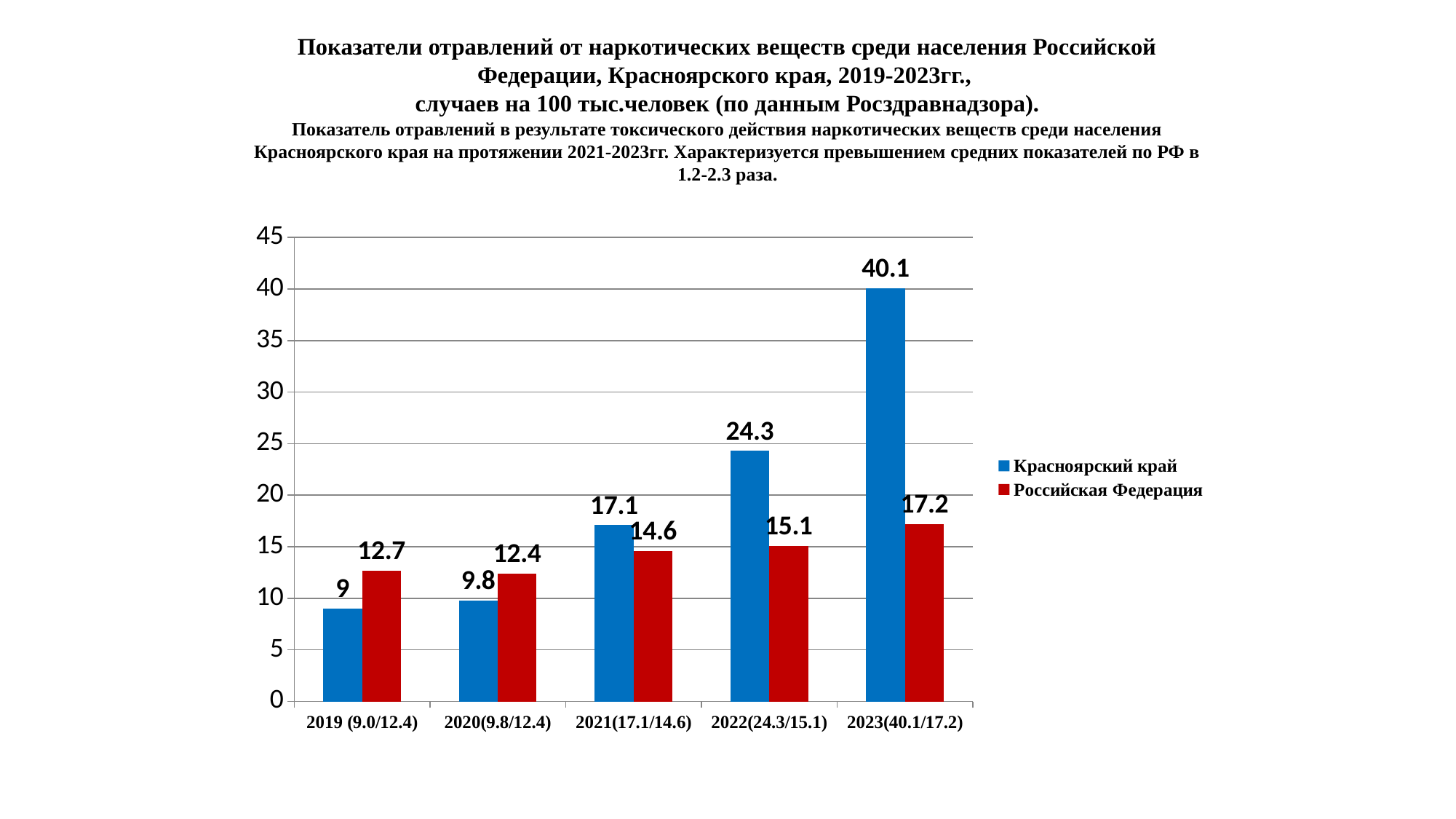
In which year is the value for Красноярский край highest? 2023 What is the difference between the Красноярский край and Российская Федерация values in 2023? 22.9 How many series does the legend list? 2 What is the value for Российская Федерация in 2021? 14.6 What kind of chart is shown on the slide? bar chart What is the value for Российская Федерация in 2022? 15.1 What is the value for Красноярский край in 2020? 9.8 What is the value for Красноярский край in 2023? 40.1 In 2020, which series has the larger value: Красноярский край or Российская Федерация? Российская Федерация How many years are shown on the x axis? 5 Is the value for Красноярский край in 2022 greater or less than 20? greater In which year is the value for Красноярский край lowest? 2019